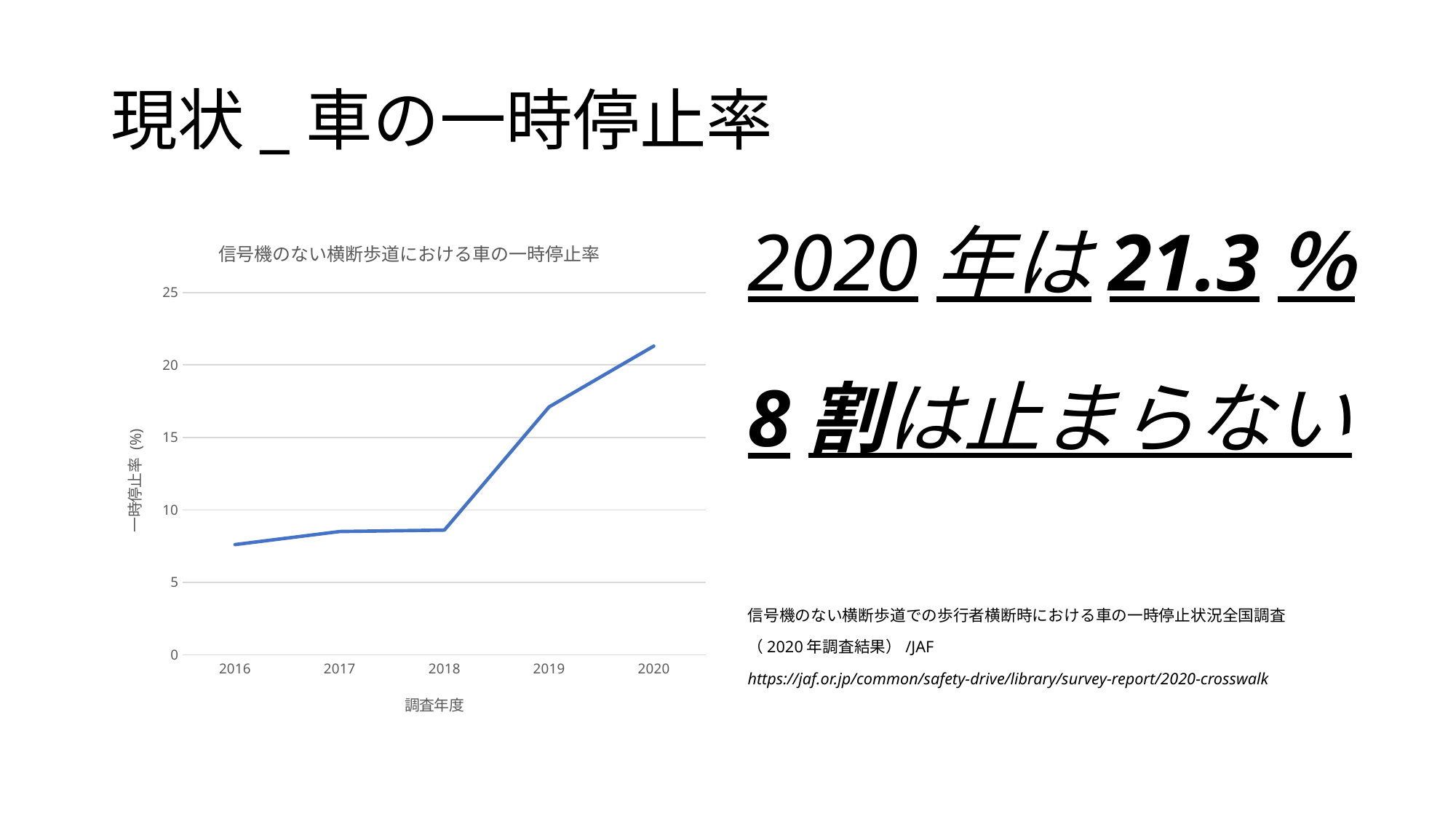
What is the label of the x axis? 調査年度 Which is larger, the value for 2018 or the value for 2019? 2019 What is the value for 2020 on the chart? 21.3% Is the value for 2018 greater or less than 10? less How many years (data points) are plotted on the chart? 5 Which year has the lowest value on the chart? 2016 What kind of chart is shown on the slide? Line chart Is the value for 2016 greater or less than 10? less Is the value for 2019 greater or less than 15? greater What is the title of the chart? 信号機のない横断歩道における車の一時停止率 Do the values rise or fall from 2016 to 2020? Rise Which year has the highest value on the chart? 2020